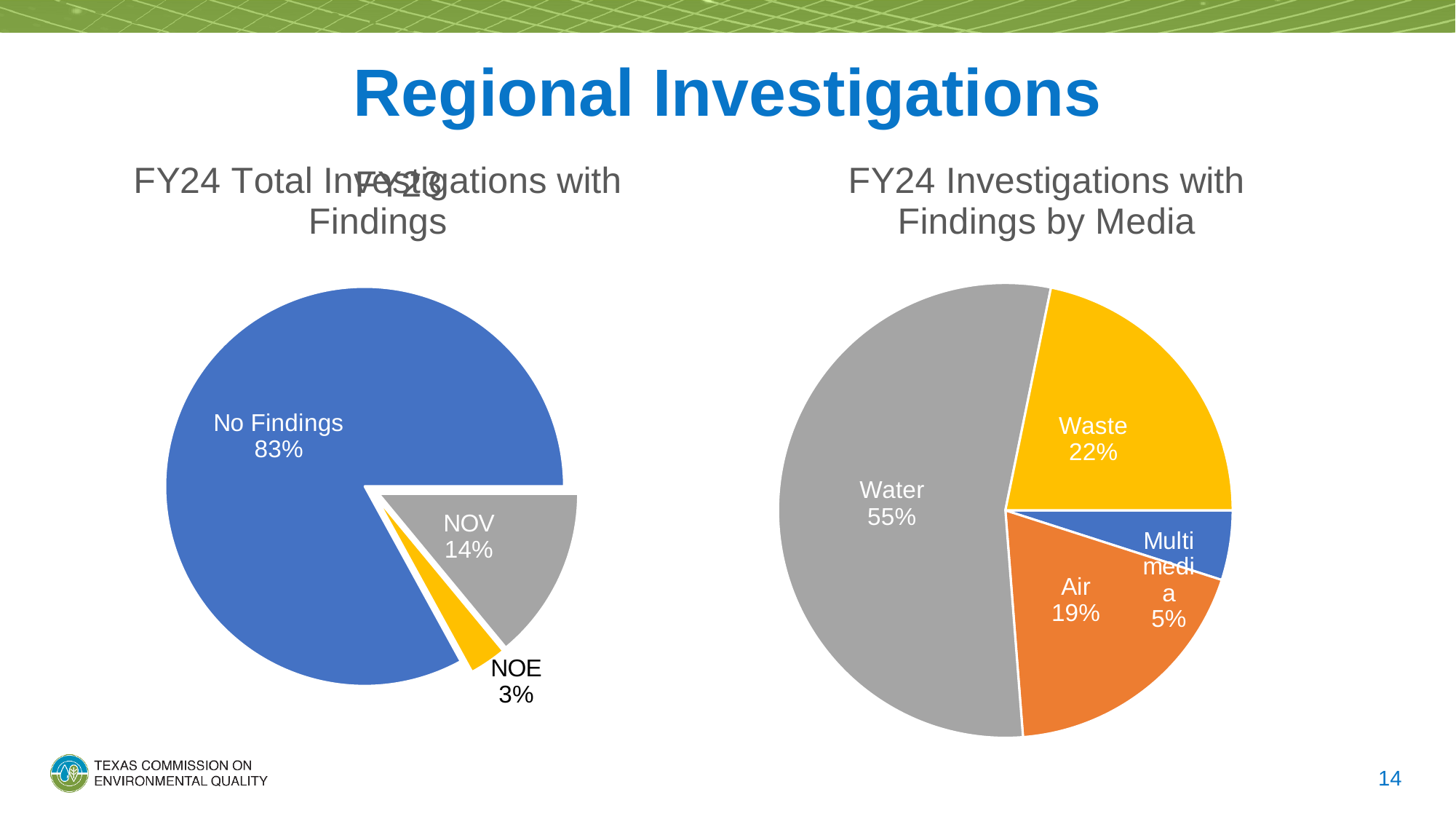
In the left pie chart, what percentage is shown for NOE? 3% In the chart titled 'FY24 Investigations with Findings by Media', what share is Water? 55% In the chart titled 'FY24 Investigations with Findings by Media', which media has the smallest share? Multimedia In the chart titled 'FY24 Investigations with Findings by Media', which media has the largest share? Water How many slices does the left pie chart have? 3 What type of chart is used for 'FY24 Investigations with Findings by Media'? Pie chart In the left pie chart, what share is labelled for No Findings? 83% In the chart titled 'FY24 Investigations with Findings by Media', what share is Waste? 22% In the left pie chart, which slice is the smallest? NOE In the chart titled 'FY24 Investigations with Findings by Media', what is the difference in percentage points between Waste and Air? 3 In the chart titled 'FY24 Investigations with Findings by Media', what share is Air? 19% In the left pie chart, what percentage is shown for NOV? 14%